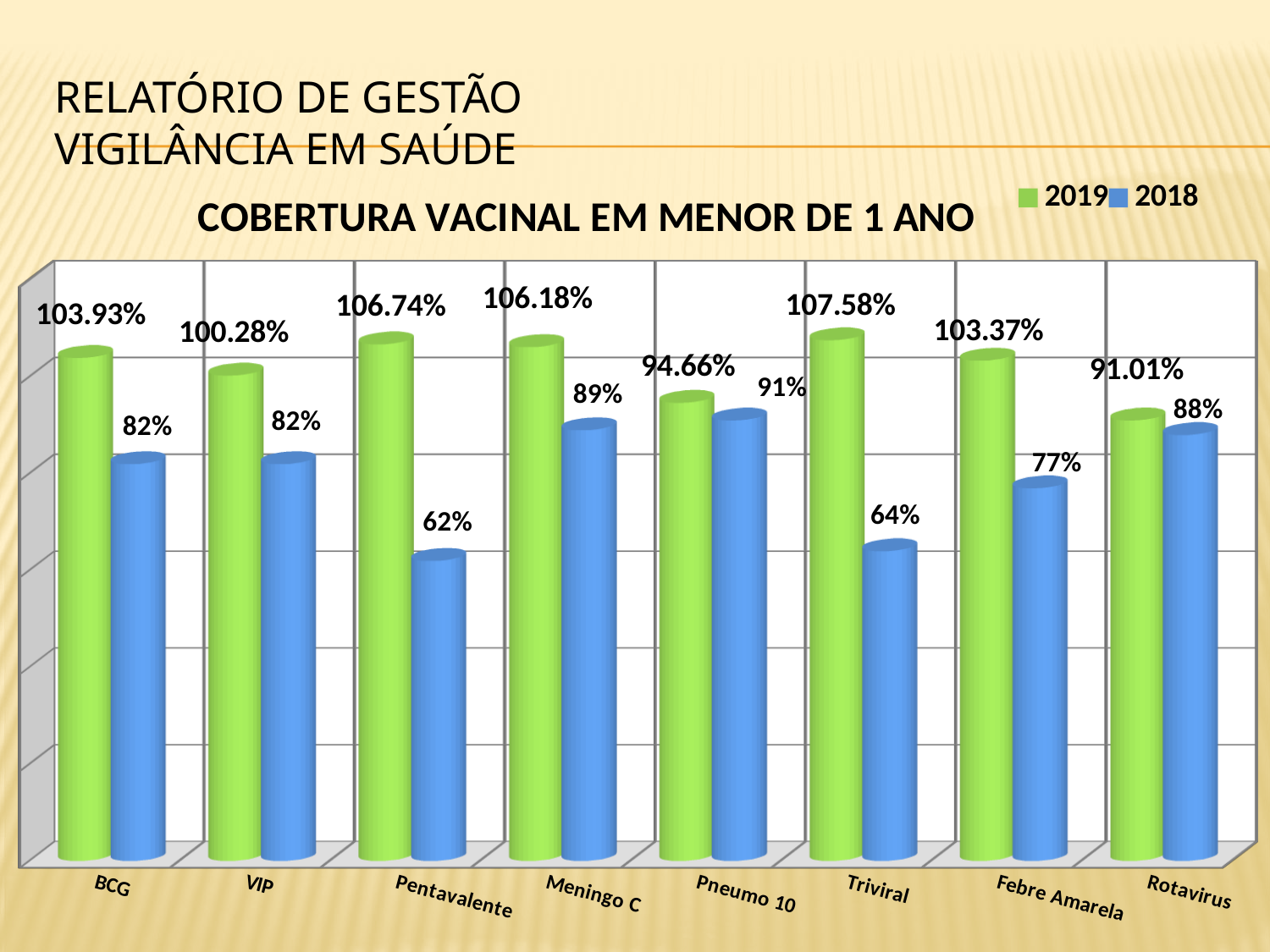
What kind of chart is shown? Bar chart What is the 2018 value for Triviral? 64% Which vaccine has the highest 2019 coverage? Triviral What is the difference between the 2019 and 2018 values for Febre Amarela? 26.37% How many series does the legend list? 2 What is the 2019 value for Pentavalente? 106.74% Which vaccine has the lowest 2018 coverage? Pentavalente What is the 2019 value for Rotavirus? 91.01% Which vaccine has the lowest 2019 coverage? Rotavirus How many vaccines are shown on the x axis? 8 What is the title of the chart? COBERTURA VACINAL EM MENOR DE 1 ANO Which is larger for Pneumo 10: the 2019 value or the 2018 value? 2019